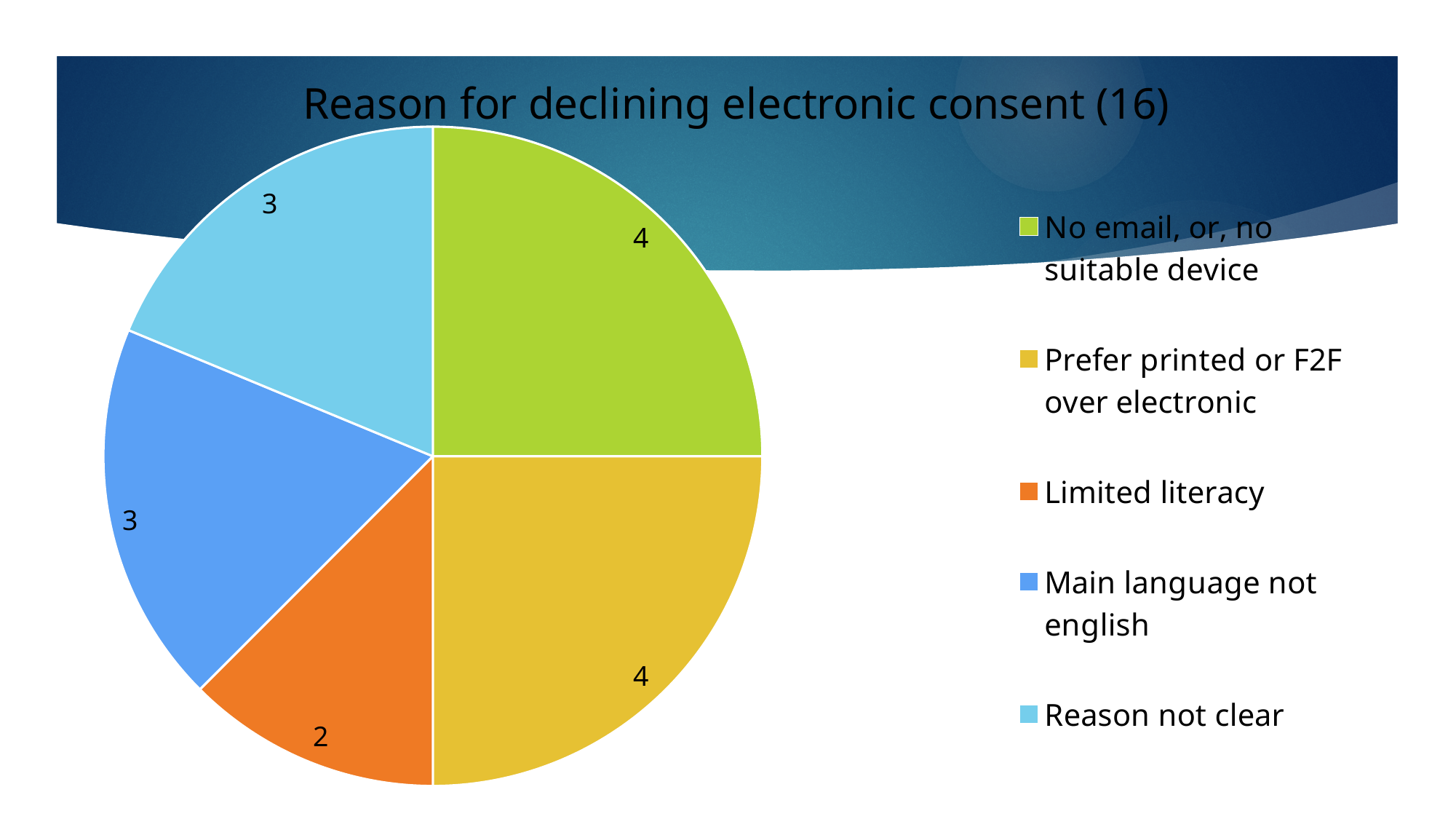
What share of the pie does 'Prefer printed or F2F over electronic' represent? 25% What is the value for 'No email, or, no suitable device'? 4 What is the difference between the value for 'Prefer printed or F2F over electronic' and the value for 'Limited literacy'? 2 What is the value for 'Main language not english'? 3 What is the value for 'Reason not clear'? 3 What is the value for 'Limited literacy'? 2 What is the total of all the slice values in the pie chart? 16 How many categories does the pie chart have? 5 What is the title of the chart? Reason for declining electronic consent (16) Which reason has the smallest slice of the pie? Limited literacy Which is larger: the value for 'No email, or, no suitable device' or the value for 'Reason not clear'? No email, or, no suitable device What type of chart is shown on the slide? Pie chart